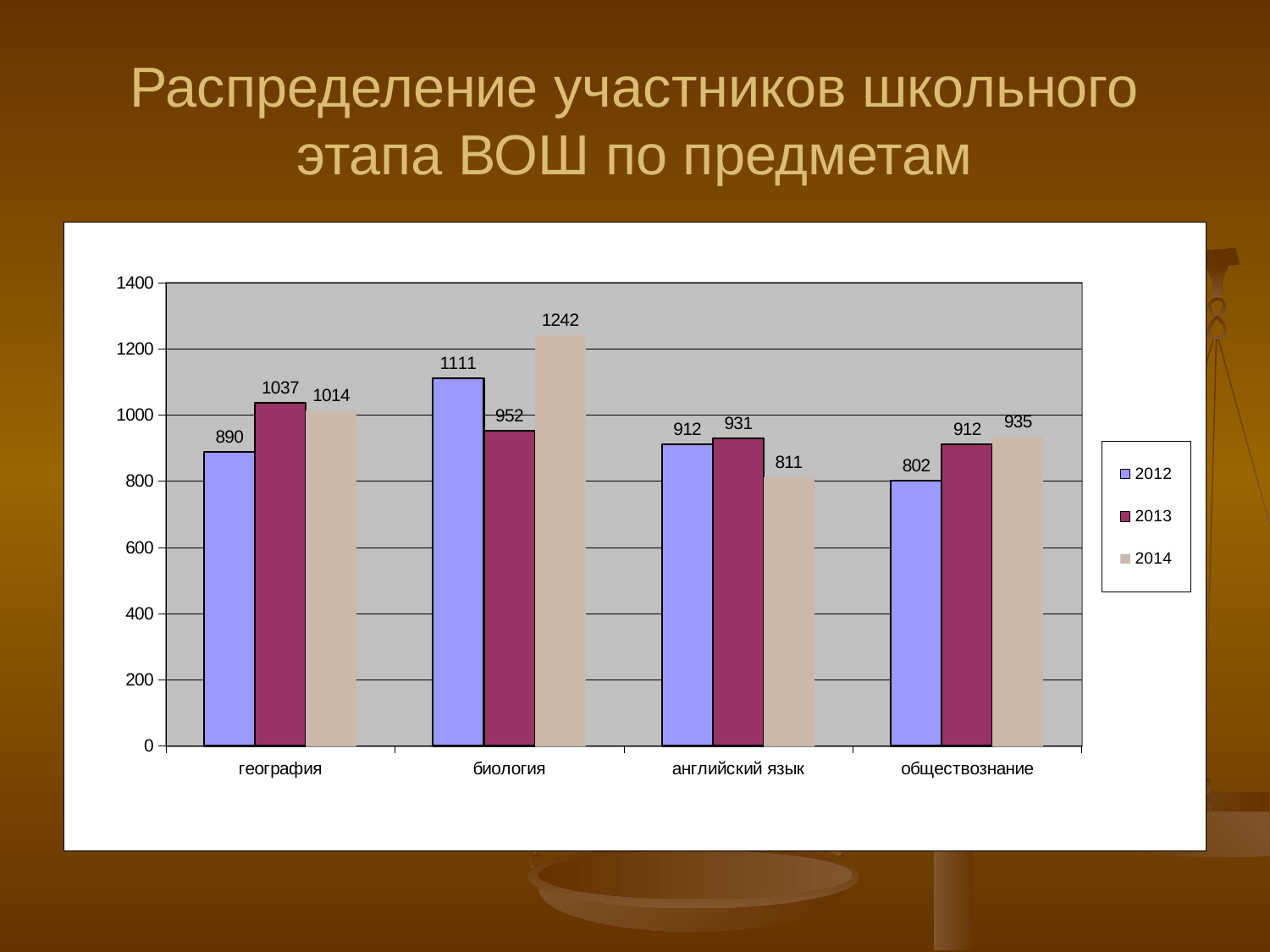
What is the value for биология in 2014? 1242 Which subject has the highest value in 2014? биология Is the value for английский язык in 2014 greater or less than 1000? less How many series does the legend list? 3 What is the value for обществознание in 2012? 802 What kind of chart is shown on the slide? bar chart Which is larger for география: the 2013 value or the 2014 value? 2013 How many subjects are shown on the x axis? 4 Which subject has the lowest value in 2012? обществознание What is the difference between the 2014 and 2012 values for биология? 131 What is the value for английский язык in 2013? 931 What is the value for география in 2012? 890